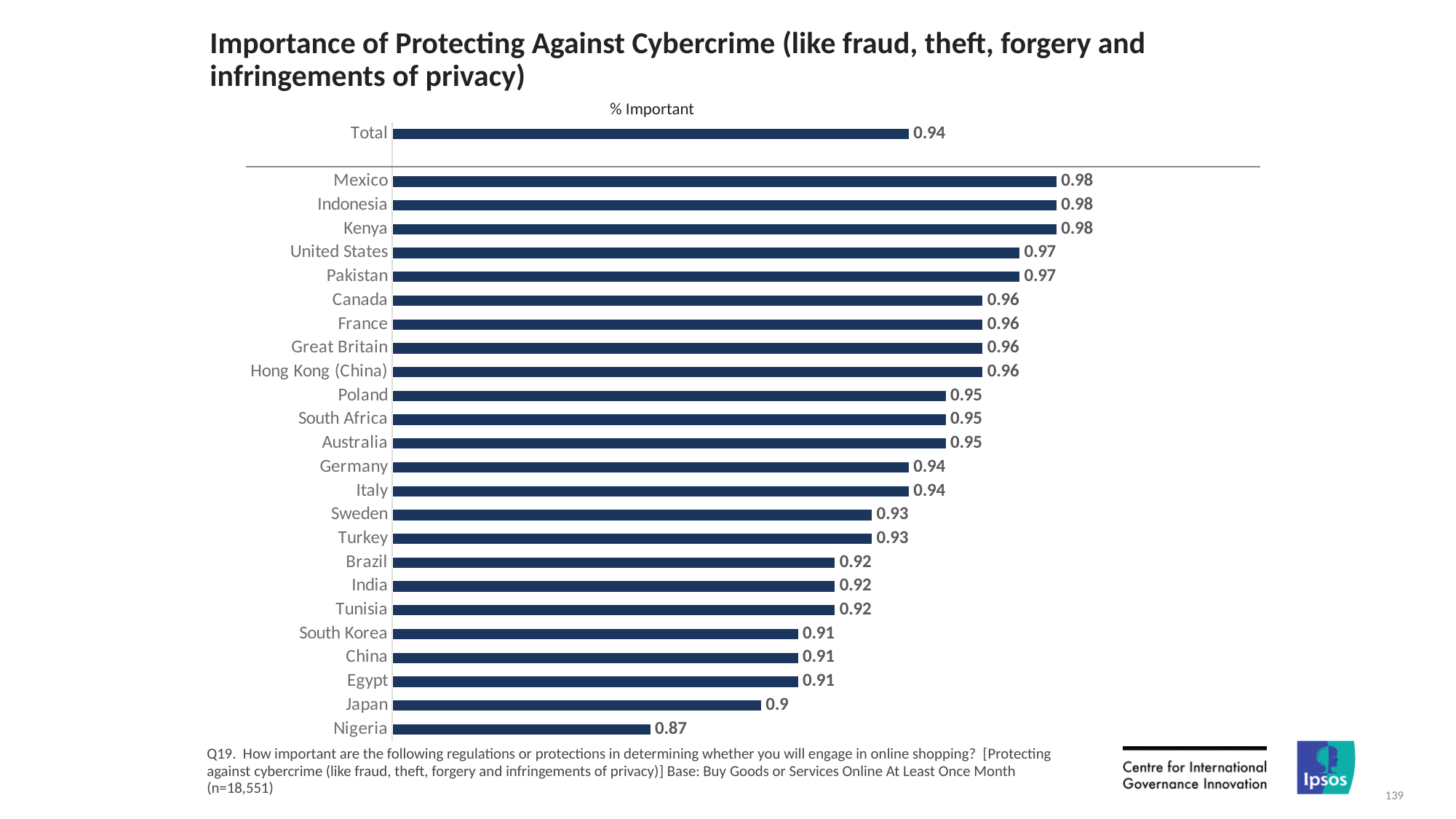
What kind of chart is shown on the slide? Bar chart What is the difference between the values for United States and Japan? 0.07 Which has a larger value, Egypt or Poland? Poland What is the difference between the values for Mexico and Nigeria? 0.11 What is the label shown above the chart, under the title? % Important What is the value for Hong Kong (China)? 0.96 What is the value for Japan? 0.9 Which has a larger value, Canada or Sweden? Canada How many countries are listed below the Total bar? 24 Which country has the lowest value? Nigeria What is the value for Nigeria? 0.87 What is the value for Total? 0.94